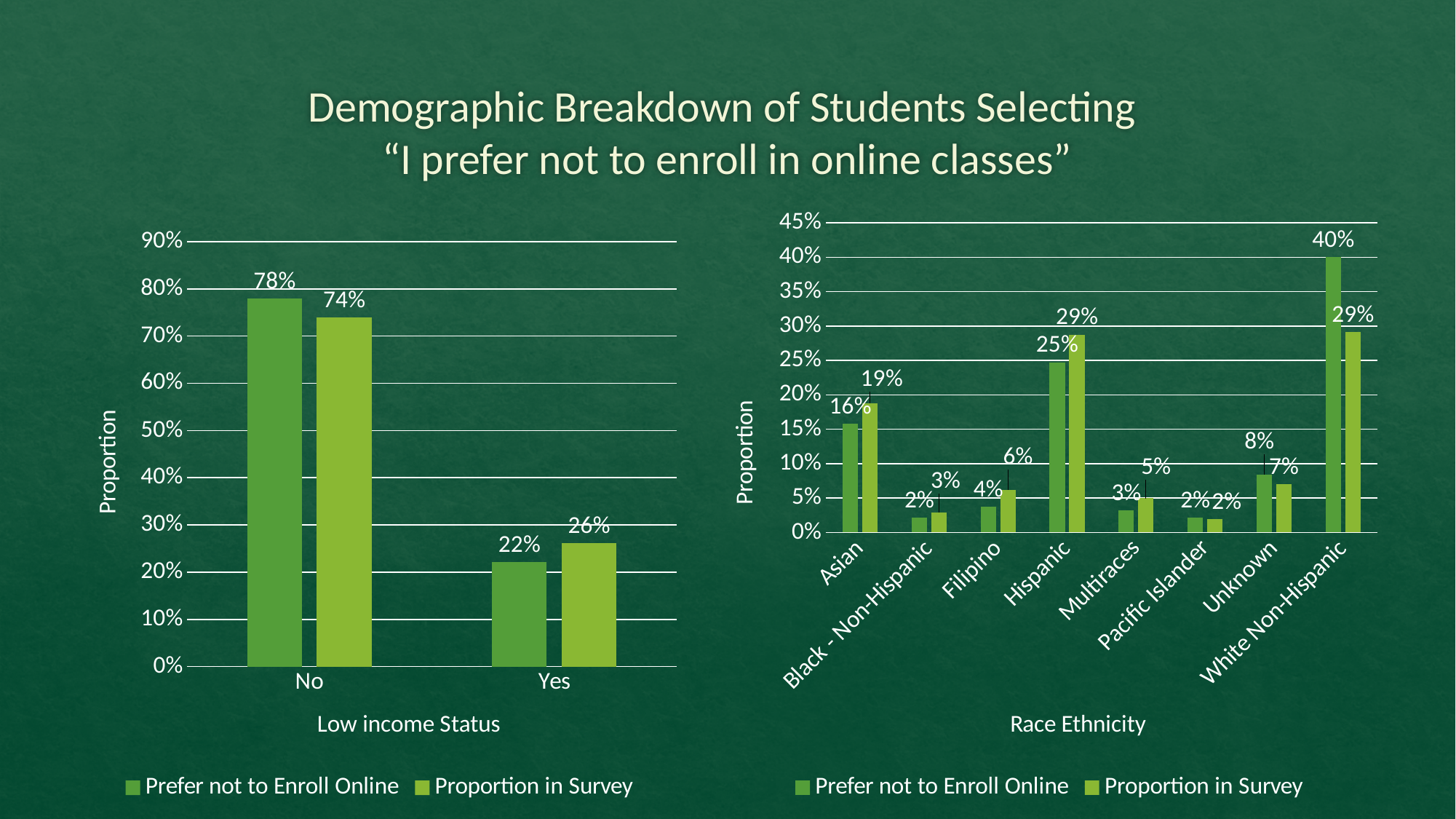
In the Low income Status chart, how many series does the legend list? 2 In the Race Ethnicity chart, what is the value of Prefer not to Enroll Online for Hispanic? 25% In the Race Ethnicity chart, which is larger for Unknown: Prefer not to Enroll Online or Proportion in Survey? Prefer not to Enroll Online In the Low income Status chart, what is the value of Proportion in Survey for Yes? 26% In the Race Ethnicity chart, what is the value of Proportion in Survey for White Non-Hispanic? 29% In the Race Ethnicity chart, what is the difference between Prefer not to Enroll Online and Proportion in Survey for White Non-Hispanic? 11% In the Low income Status chart, what is the difference between Prefer not to Enroll Online and Proportion in Survey for No? 4% What kind of chart is the Race Ethnicity chart? Bar chart In the Race Ethnicity chart, which category has the highest Prefer not to Enroll Online value? White Non-Hispanic In the Low income Status chart, what is the value of Prefer not to Enroll Online for No? 78% In the Race Ethnicity chart, how many categories are shown on the x axis? 8 In the Race Ethnicity chart, what is the value of Proportion in Survey for Filipino? 6%